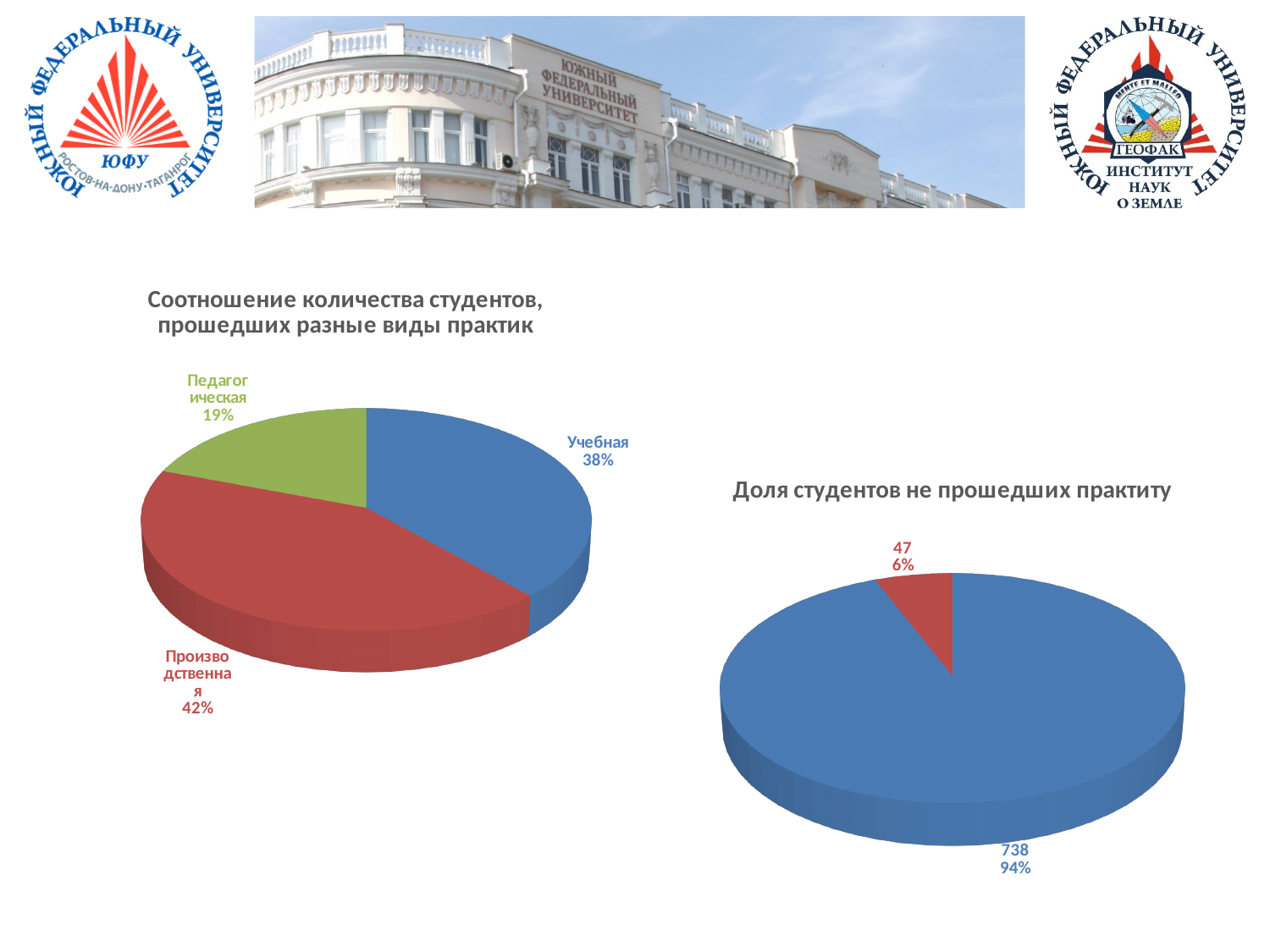
On the right chart 'Доля студентов не прошедших практиту', what is the total of the two labelled values? 785 On the left chart 'Соотношение количества студентов, прошедших разные виды практик', which type of practice has the largest share? Производственная On the left chart 'Соотношение количества студентов, прошедших разные виды практик', what share is labelled for Учебная? 38% On the left chart 'Соотношение количества студентов, прошедших разные виды практик', how many slices does the pie have? 3 On the left chart 'Соотношение количества студентов, прошедших разные виды практик', which type of practice has the smallest share? Педагогическая On the left chart 'Соотношение количества студентов, прошедших разные виды практик', what share is labelled for Производственная? 42% On the left chart 'Соотношение количества студентов, прошедших разные виды практик', what share is labelled for Педагогическая? 19% On the right chart 'Доля студентов не прошедших практиту', what value and share are labelled on the red slice? 47, 6% On the right chart 'Доля студентов не прошедших практиту', what value and share are labelled on the blue slice? 738, 94% On the left chart 'Соотношение количества студентов, прошедших разные виды практик', by how many percentage points does Производственная exceed Педагогическая? 23 percentage points What kind of chart is the right chart 'Доля студентов не прошедших практиту'? Pie chart On the left chart 'Соотношение количества студентов, прошедших разные виды практик', which is larger: Учебная or Педагогическая? Учебная